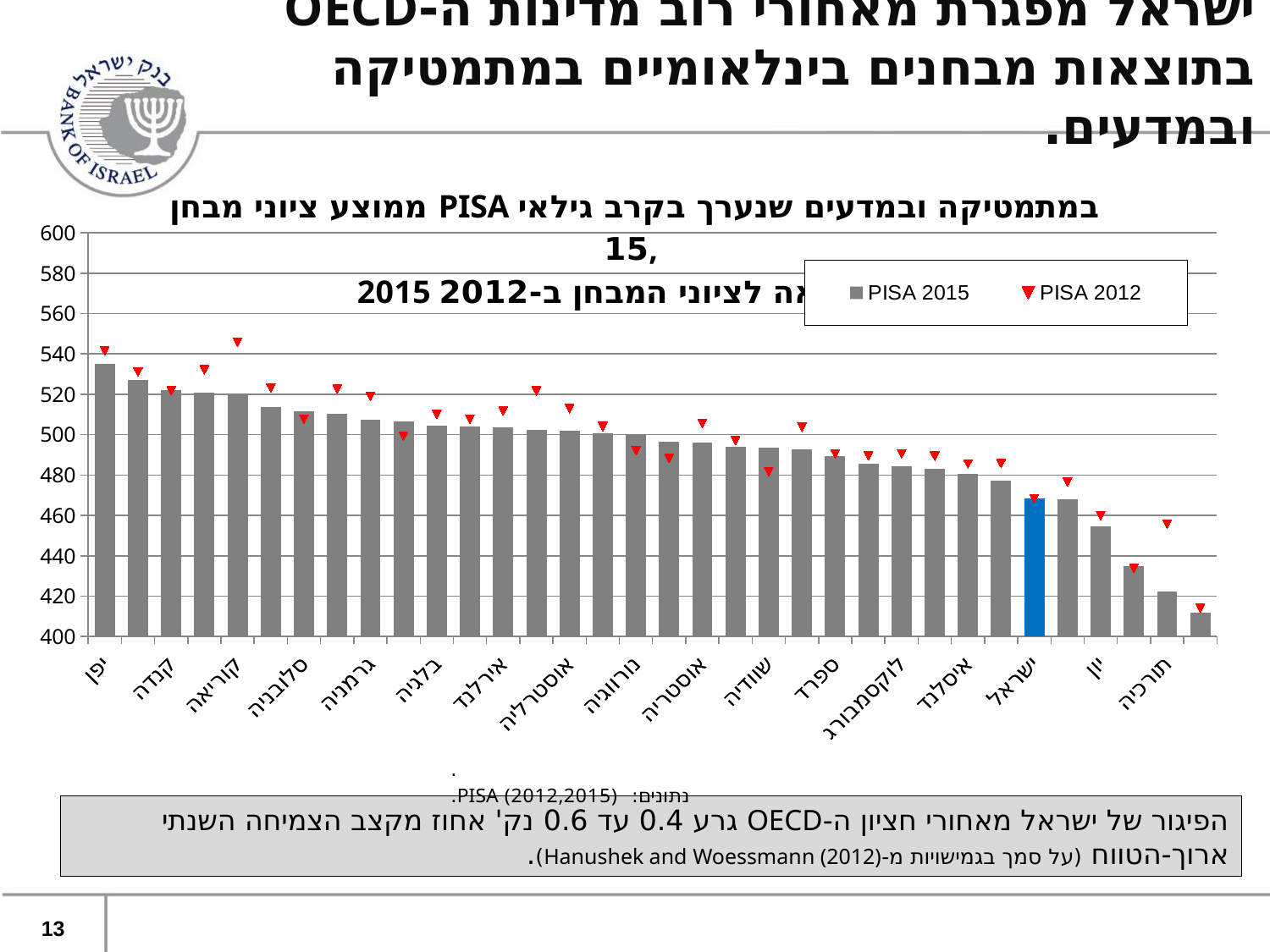
Which country's bar is highlighted in blue? ישראל How many series does the legend list? 2 Is the PISA 2015 value for יפן greater or less than 520? greater What kind of chart is shown on the slide? bar chart Is the PISA 2015 value for קנדה greater or less than 500? greater Which has the larger PISA 2015 bar, יפן or ישראל? יפן Is the PISA 2015 value for ישראל greater or less than 480? less What are the two series named in the legend? PISA 2015 and PISA 2012 Do the PISA 2015 bars rise or fall from left to right along the x axis? fall Which country has the highest PISA 2015 bar? יפן